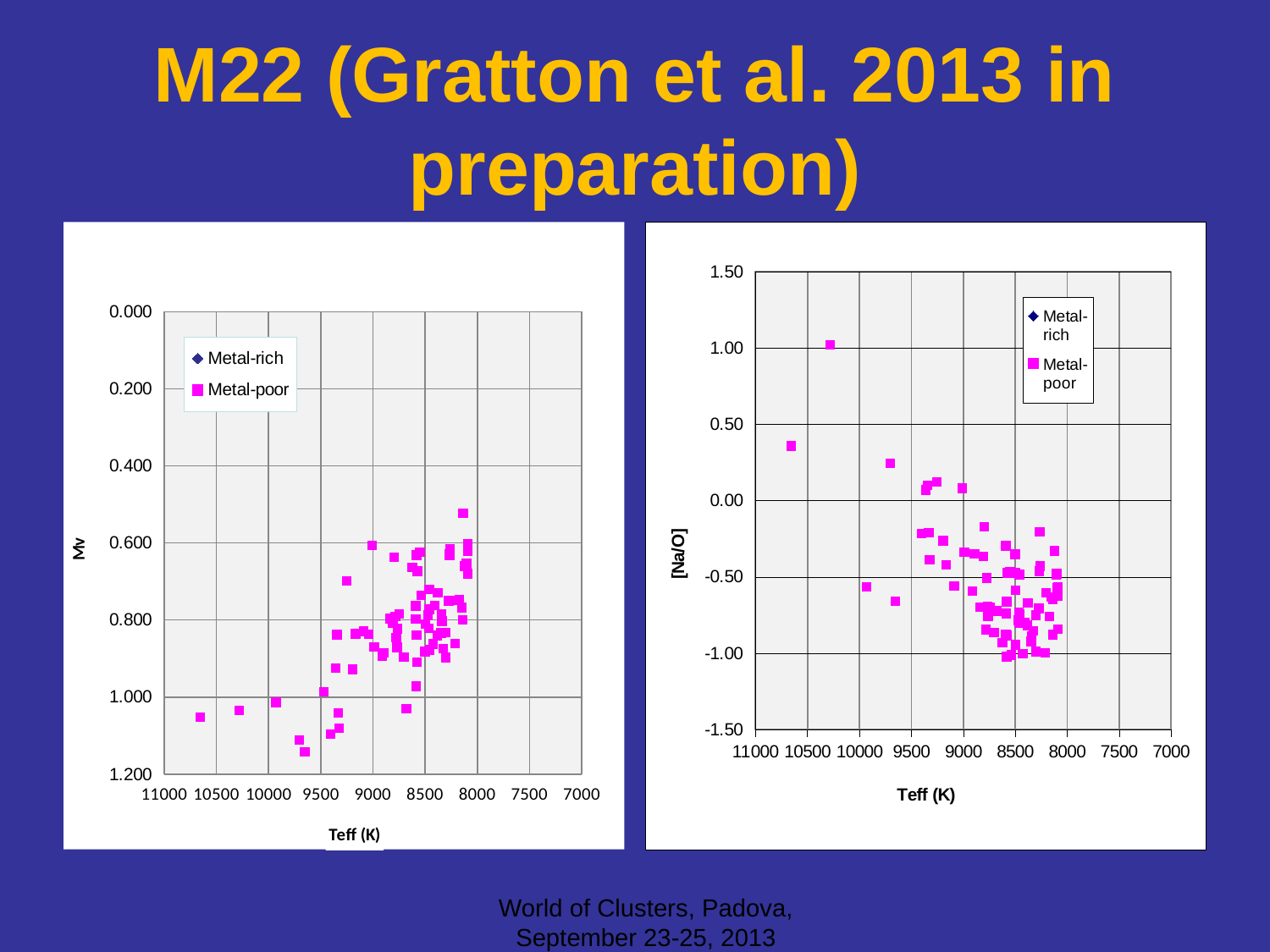
In the right chart, is the [Na/O] value of the point plotted near Teff 10000 K greater or less than 0.00? less In the right chart, do the [Na/O] values rise or fall moving from left to right along the Teff axis? fall In the left chart, is the Mv value of the point plotted near Teff 10700 K greater or less than 1.000? greater How many series does the legend of the right chart list? 2 What kind of chart is the right chart on the slide? scatter chart What kind of chart is the left chart on the slide? scatter chart What is the y-axis label of the left chart? Mv In the left chart, is the smallest plotted Mv value greater or less than 0.600? less What are the two series named in the legend of the right chart? Metal-rich and Metal-poor What is the y-axis label of the right chart? [Na/O] How many series does the legend of the left chart list? 2